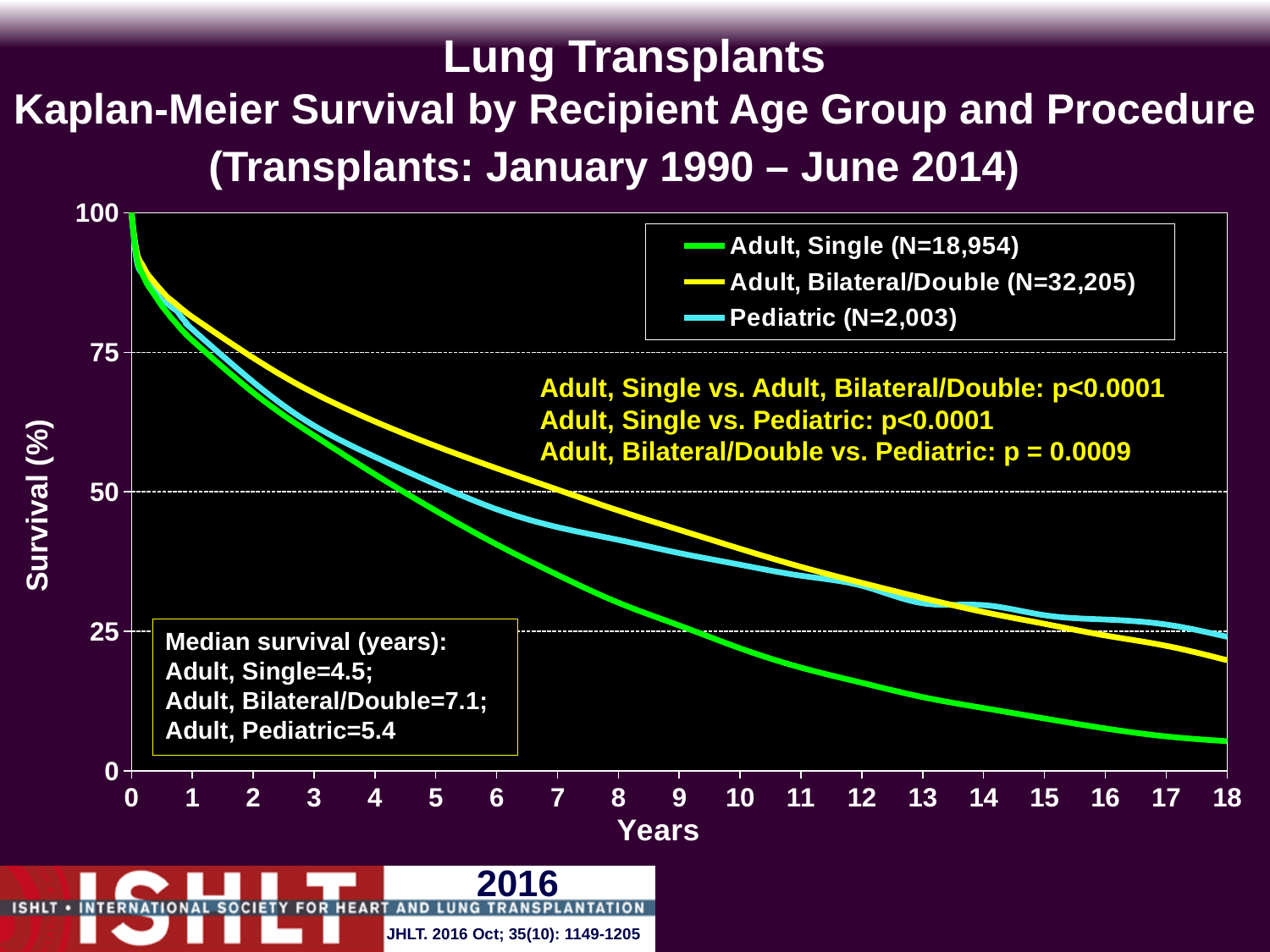
What is the median survival in years for Adult, Bilateral/Double recipients? 7.1 Do the survival curves rise or fall as years increase? Fall What is the median survival in years for Adult, Single recipients? 4.5 What kind of chart is shown on the slide? Line chart What is the N for the Pediatric group shown in the legend? 2,003 Is the survival for Adult, Bilateral/Double at 5 years greater or less than 50? greater Which group has the lowest median survival? Adult, Single What is the difference in median survival (years) between Adult, Bilateral/Double and Adult, Single? 2.6 Which has the larger median survival, Adult, Single or Pediatric? Pediatric Is the survival for Adult, Single at 18 years greater or less than 25? less How many series does the legend list? 3 Which group has the highest median survival? Adult, Bilateral/Double